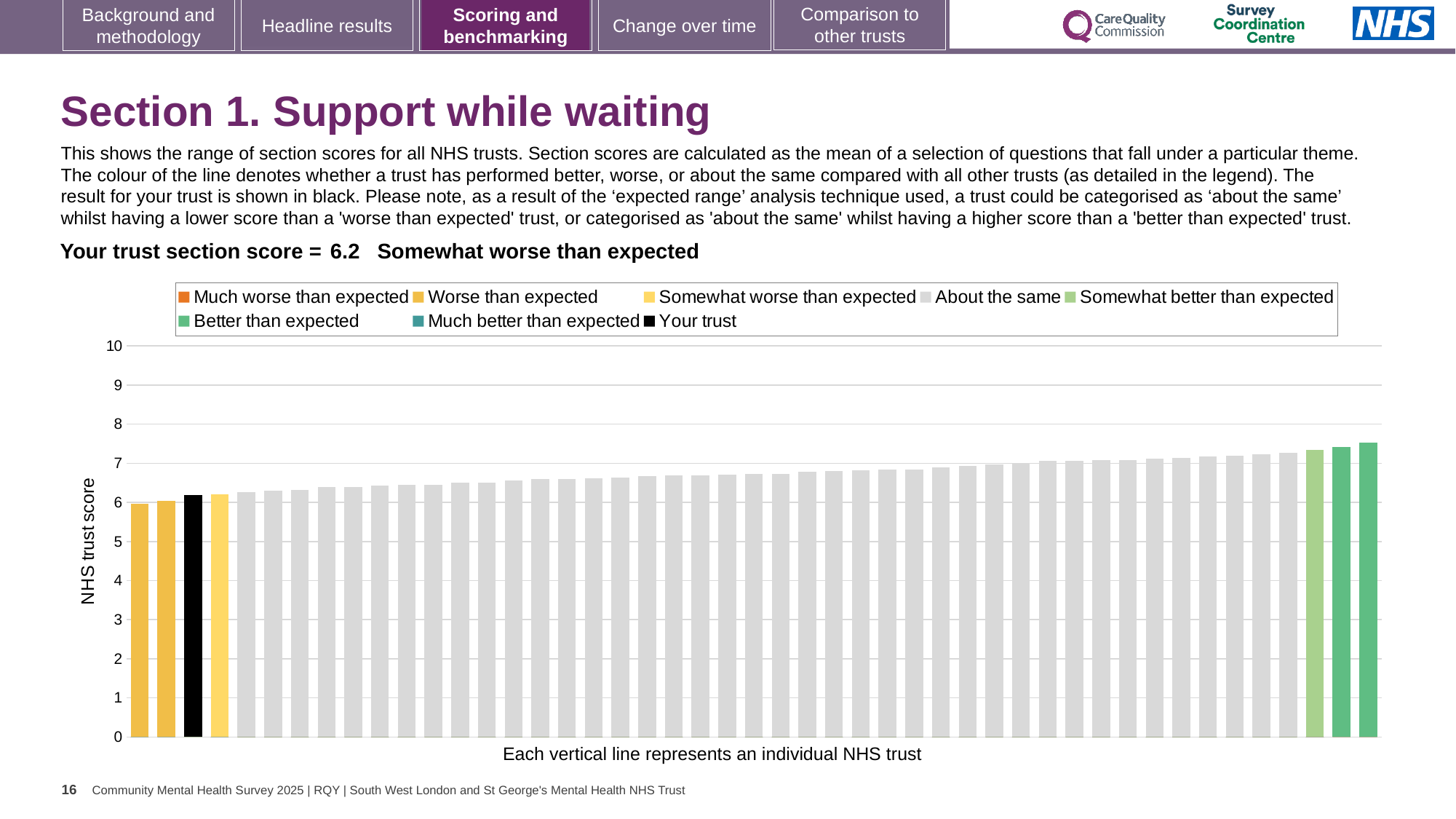
What is the section score for your trust? 6.2 How many bars are coloured as 'Better than expected'? 2 How many bars are coloured as 'Worse than expected'? 2 Do the bar values rise or fall from left to right along the x axis? rise What kind of chart is shown on the slide? bar chart How many entries does the chart legend list? 8 Which category is your trust's section score placed in? Somewhat worse than expected Is the value of the shortest bar greater or less than 7? less Which bar is taller, the leftmost bar or the rightmost bar? the rightmost bar What is the label on the vertical axis of the chart? NHS trust score Is the value for your trust greater or less than 5? greater Is the value of the tallest bar greater or less than 7? greater